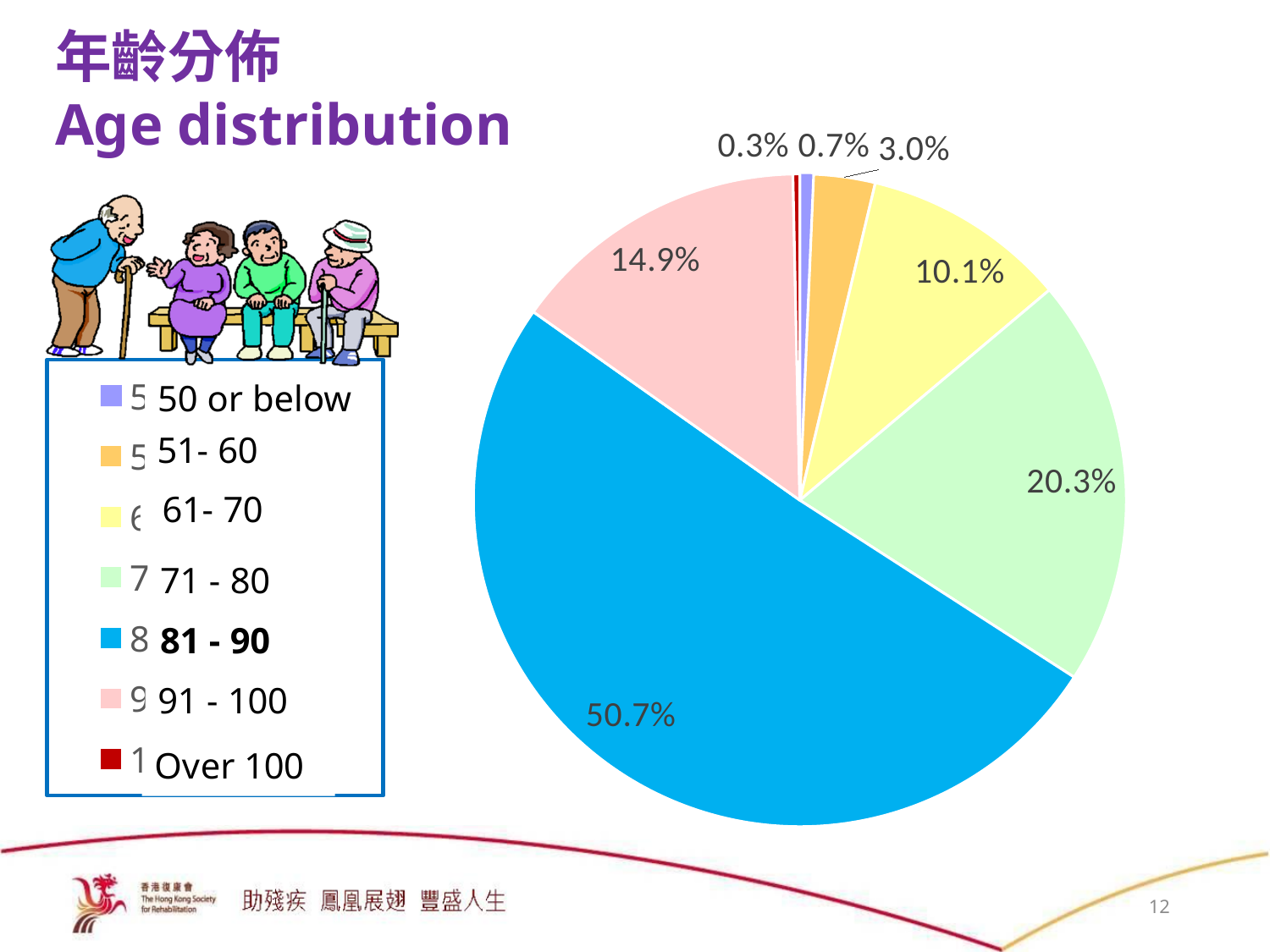
What is the difference in percentage points between the 81 - 90 and 71 - 80 age groups? 30.4 How many age groups are listed in the legend? 7 What percentage is shown for the 91 - 100 age group? 14.9% What type of chart is shown on the slide? Pie chart Which age group has the largest share of the pie? 81 - 90 What share of the pie does the 81 - 90 age group represent? 50.7% What percentage is shown for the 61- 70 age group? 10.1% Which age group has a larger share: 91 - 100 or 61- 70? 91 - 100 What percentage is shown for the 71 - 80 age group? 20.3% What percentage is shown for the 51- 60 age group? 3.0% Which age group has the smallest share of the pie? Over 100 What colour is the slice for the 81 - 90 age group? Blue